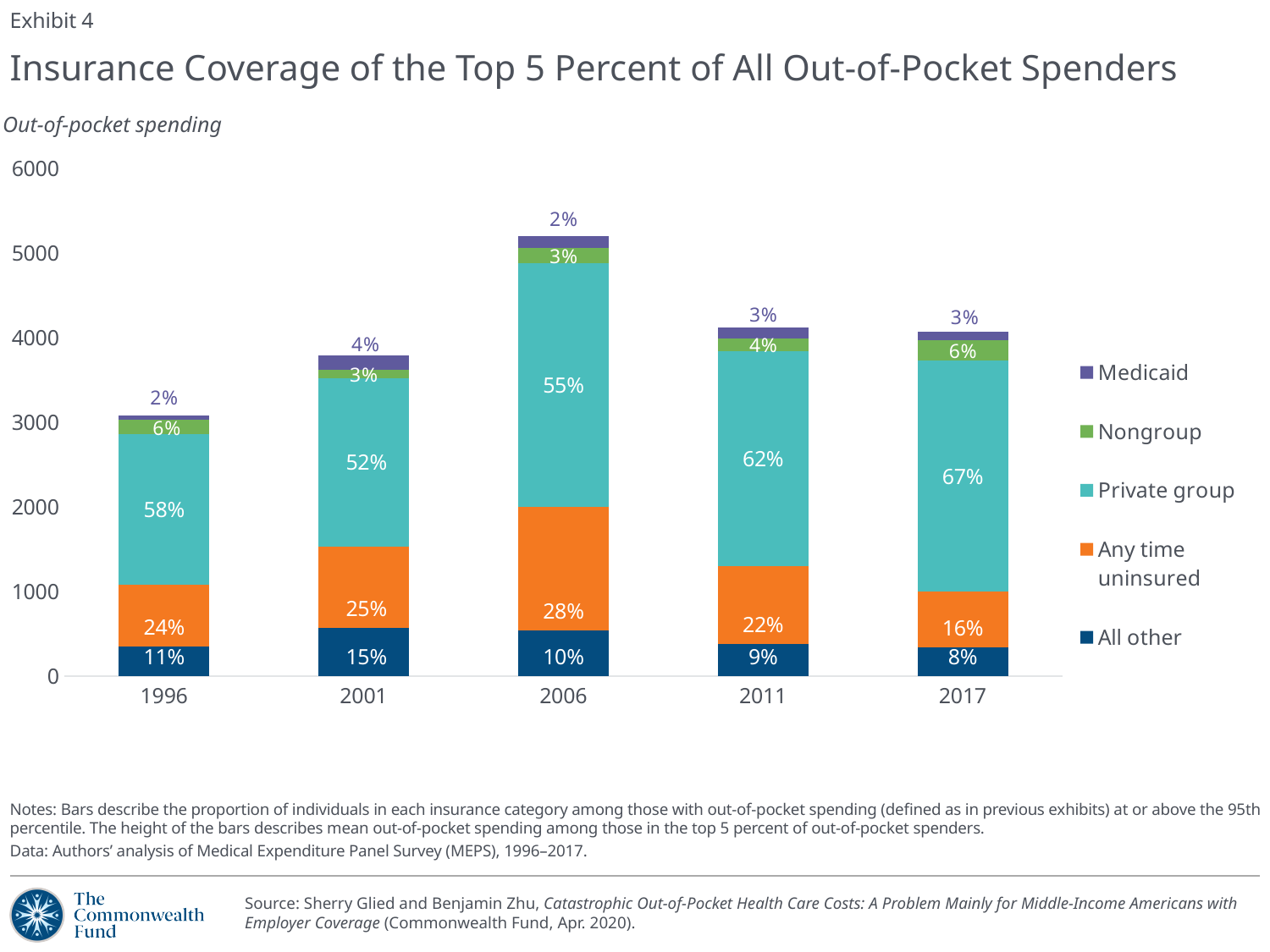
Which year has the tallest bar (highest mean out-of-pocket spending)? 2006 What percentage of the 2006 bar is Any time uninsured? 28% What percentage of the 2001 bar is Medicaid? 4% What percentage of the 2001 bar is All other? 15% How many series does the legend list? 5 Which year has the larger Any time uninsured share, 2001 or 2011? 2001 Is the total height of the 2006 bar greater or less than 5000? greater How many years are shown on the x axis? 5 Which year has the lowest All other percentage? 2017 Is the total height of the 2001 bar greater or less than 4000? less What percentage of the 2017 bar is Private group? 67% By how many percentage points does the Private group share in 2017 exceed that in 1996? 9 percentage points